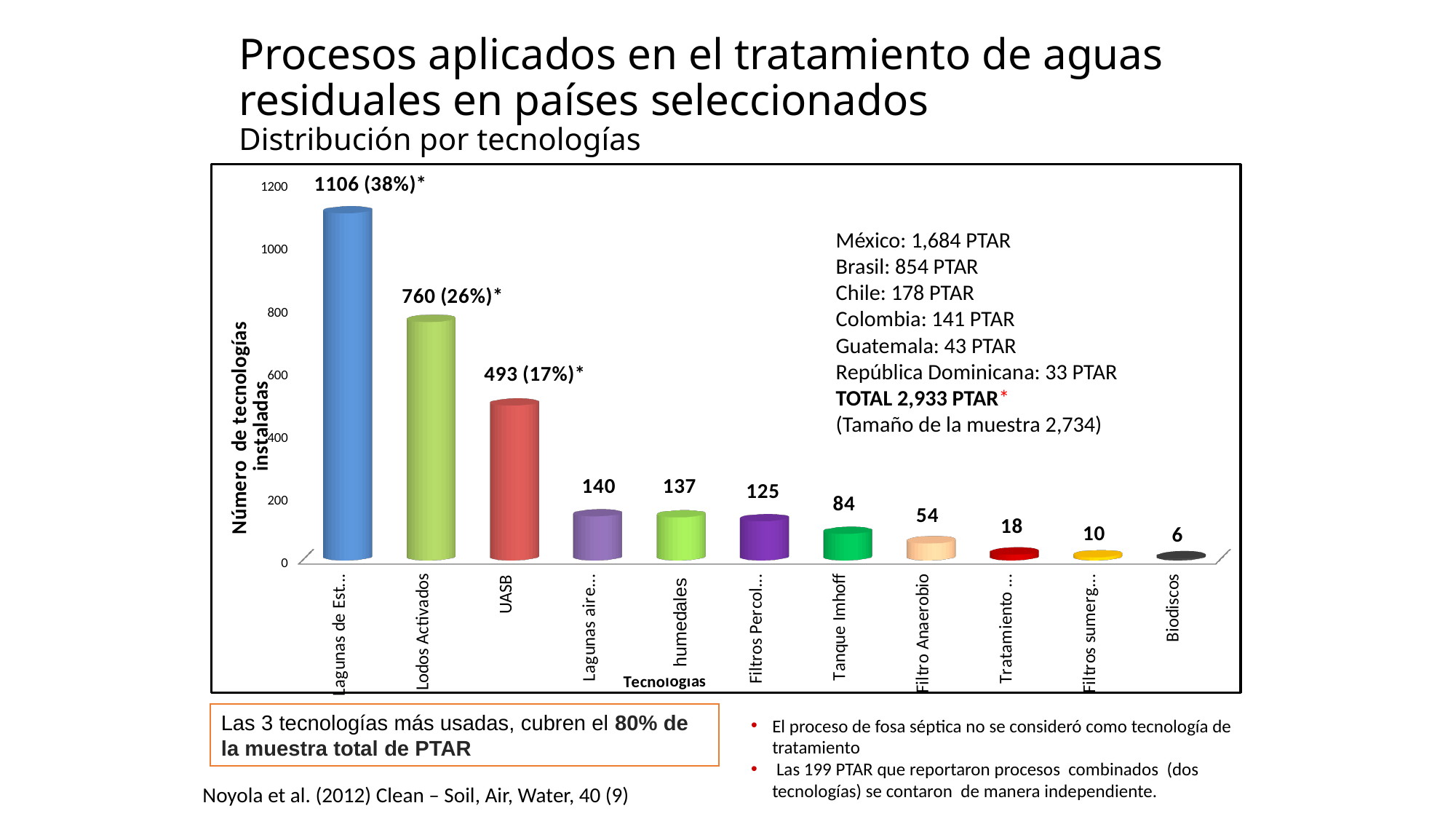
What kind of chart is shown on the slide? bar chart What is the difference between the values for Tanque Imhoff and Filtro Anaerobio? 30 Which has a larger value, humedales or Tanque Imhoff? humedales Which technology has the lowest number of installed technologies? Biodiscos Is the value for Lodos Activados greater or less than 800? less What is the value for Tanque Imhoff? 84 What is the title of the vertical axis? Número de tecnologías instaladas What data label is printed above the UASB bar? 493 (17%)* What is the value for Biodiscos? 6 What is the value for Lodos Activados? 760 How many technology categories are shown on the x axis? 11 Do the values rise or fall from left to right along the x axis? fall